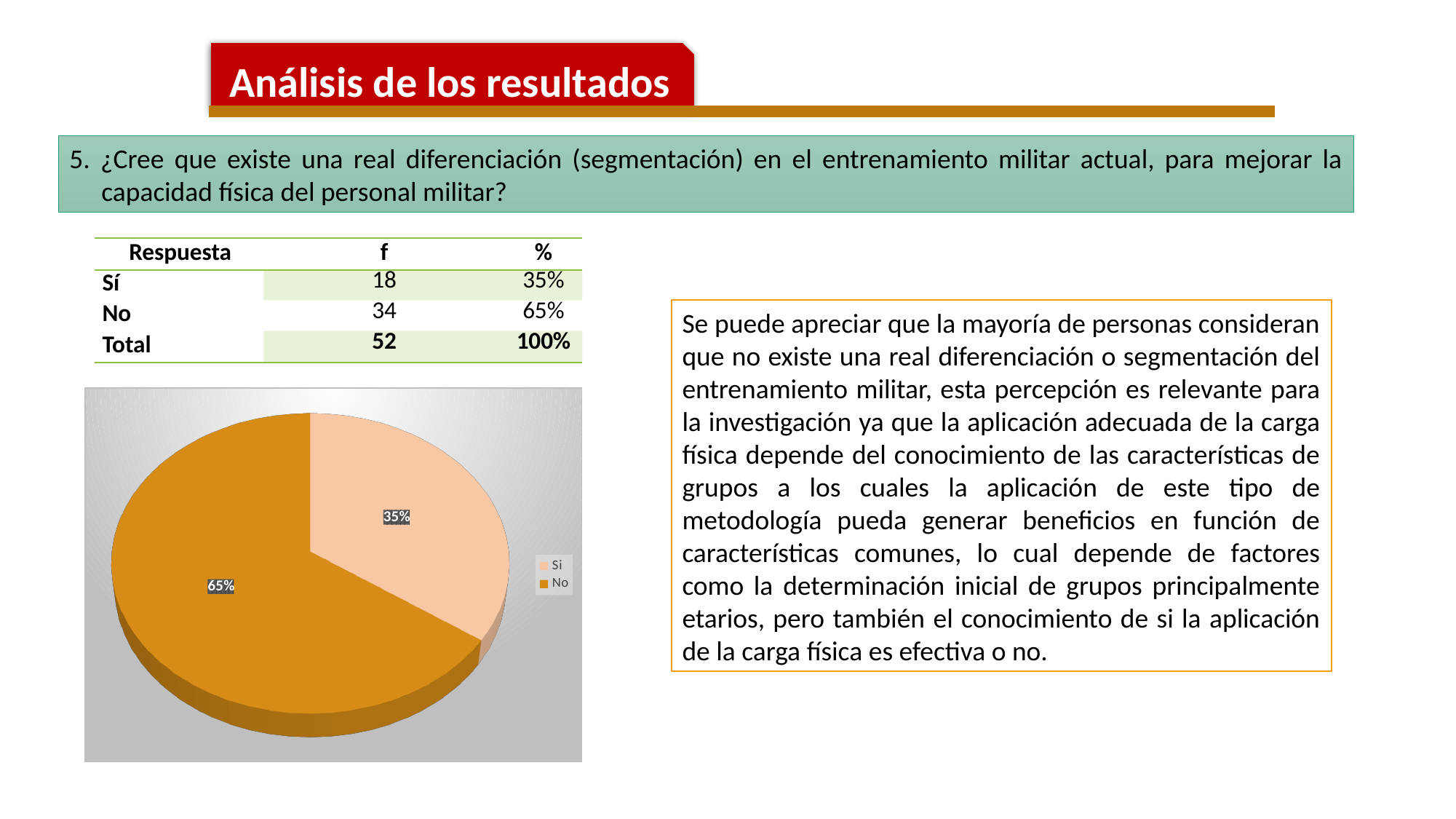
What share of the pie does the 'Si' slice represent? 35% What percentage does the 'Si' slice of the pie chart show? 35% What percentage does the 'No' slice of the pie chart show? 65% What is the difference in percentage points between the 'No' and 'Si' slices of the pie chart? 30 Which colour represents 'No' in the pie chart? orange Which slice of the pie chart is the smallest? Si Which is larger in the pie chart, the 'Si' slice or the 'No' slice? No How many entries does the pie chart legend list? 2 Which slice of the pie chart is the largest? No What are the two legend entries of the pie chart? Si, No How many slices does the pie chart have? 2 What kind of chart is shown on the slide? pie chart